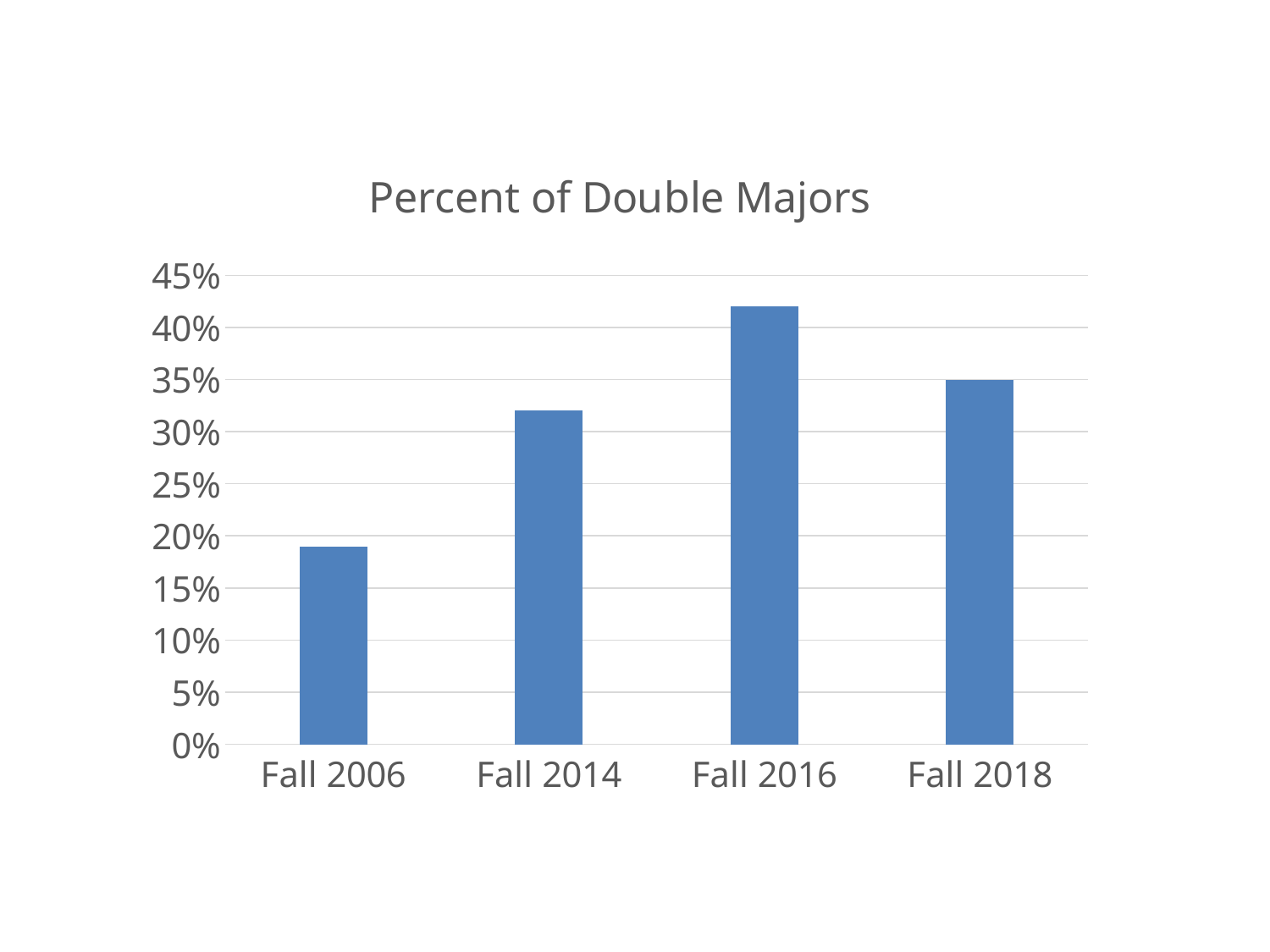
How many categories are shown on the x axis of the chart? 4 Is the value for Fall 2016 greater or less than 40%? greater Does the percent of double majors rise or fall from Fall 2006 to Fall 2016? rise Which is larger, the value for Fall 2006 or the value for Fall 2016? Fall 2016 What type of chart is shown on the slide? bar chart Is the value for Fall 2006 greater or less than 20%? less Which category has the lowest percent of double majors? Fall 2006 Is the value for Fall 2014 greater or less than 30%? greater Which category has the highest percent of double majors? Fall 2016 What is the title of the chart? Percent of Double Majors Which is larger, the value for Fall 2014 or the value for Fall 2018? Fall 2018